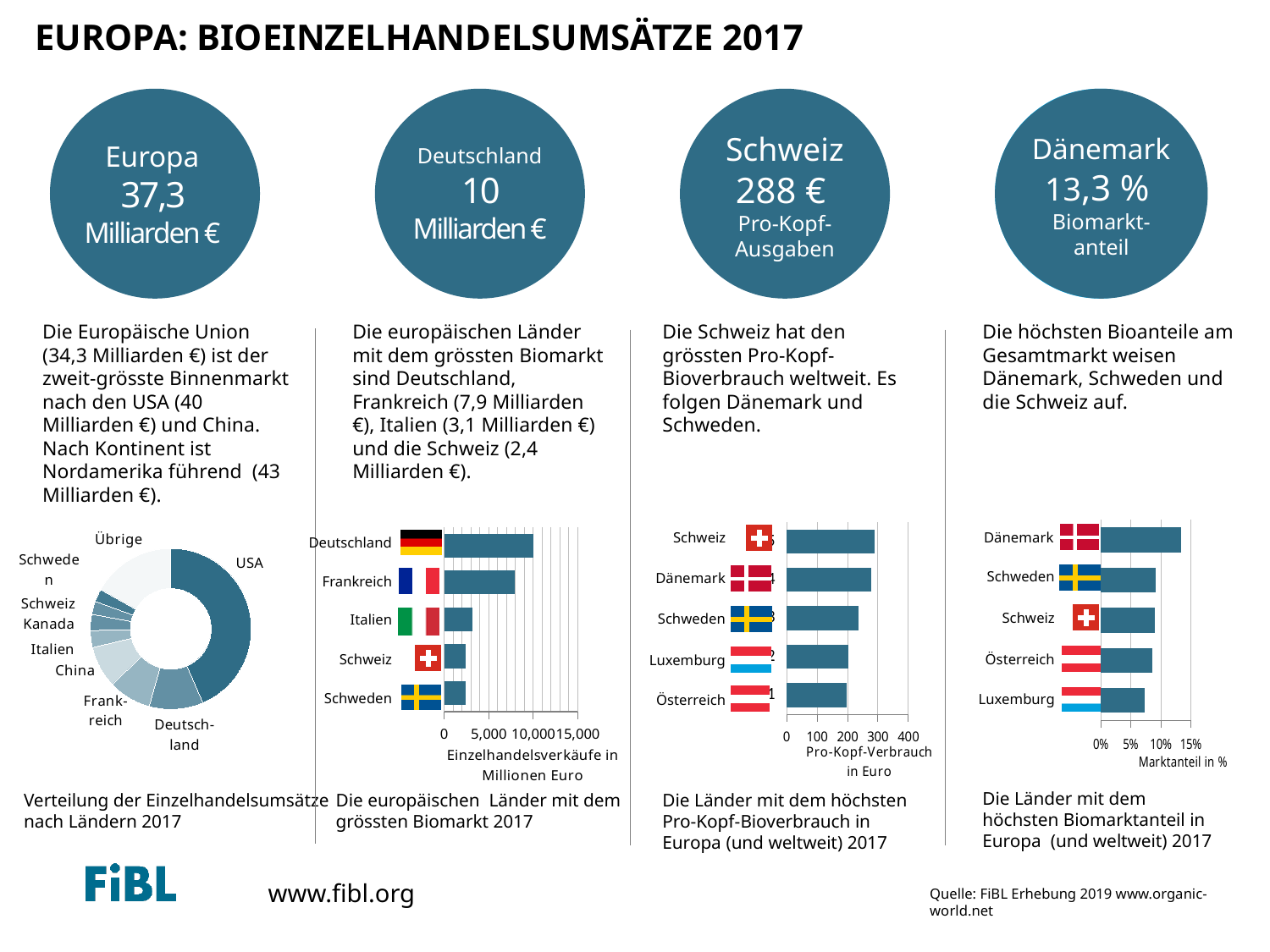
In the chart 'Verteilung der Einzelhandelsumsätze nach Ländern 2017', what kind of chart is shown? Pie (donut) chart In the chart 'Die europäischen Länder mit dem grössten Biomarkt 2017', is the value for Frankreich greater or less than 5,000? greater In the chart 'Die Länder mit dem höchsten Pro-Kopf-Bioverbrauch in Europa (und weltweit) 2017', is the value for Schweden greater or less than 200? greater In the chart 'Die europäischen Länder mit dem grössten Biomarkt 2017', how many countries are shown? 5 In the chart 'Die Länder mit dem höchsten Pro-Kopf-Bioverbrauch in Europa (und weltweit) 2017', which country has the highest per-capita consumption? Schweiz In the chart 'Verteilung der Einzelhandelsumsätze nach Ländern 2017', which country has the largest slice? USA In the chart 'Die europäischen Länder mit dem grössten Biomarkt 2017', is the value for Italien greater or less than 5,000? less In the chart 'Verteilung der Einzelhandelsumsätze nach Ländern 2017', how many labelled slices are there? 9 In the chart 'Die Länder mit dem höchsten Pro-Kopf-Bioverbrauch in Europa (und weltweit) 2017', what is the x-axis label? Pro-Kopf-Verbrauch in Euro In the chart 'Die europäischen Länder mit dem grössten Biomarkt 2017', which country has the highest retail sales? Deutschland In the chart 'Die Länder mit dem höchsten Biomarktanteil in Europa (und weltweit) 2017', which country has the lowest market share? Luxemburg